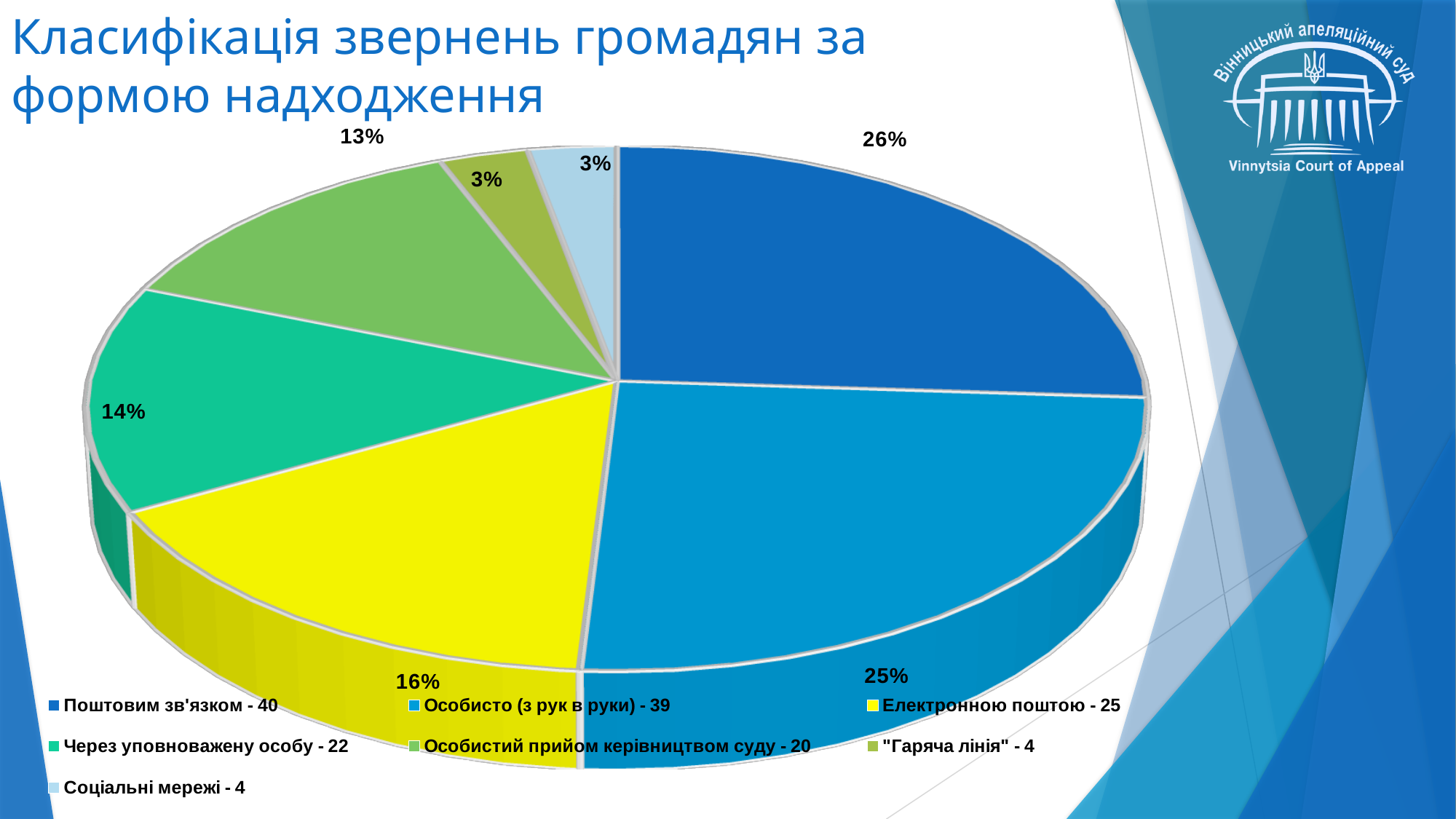
What share of the pie does Особистий прийом керівництвом суду take? 13% What kind of chart is shown on the slide? pie chart What is the difference between the number of appeals for Поштовим зв'язком and Особисто (з рук в руки)? 1 What share of the pie does Через уповноважену особу take? 14% What share of the pie does Електронною поштою take? 16% Which category has the largest number of appeals? Поштовим зв'язком What is the title of the chart on the slide? Класифікація звернень громадян за формою надходження How many categories does the pie chart have? 7 Which has more appeals: Електронною поштою or Через уповноважену особу? Електронною поштою What is the number of appeals for Через уповноважену особу according to the legend? 22